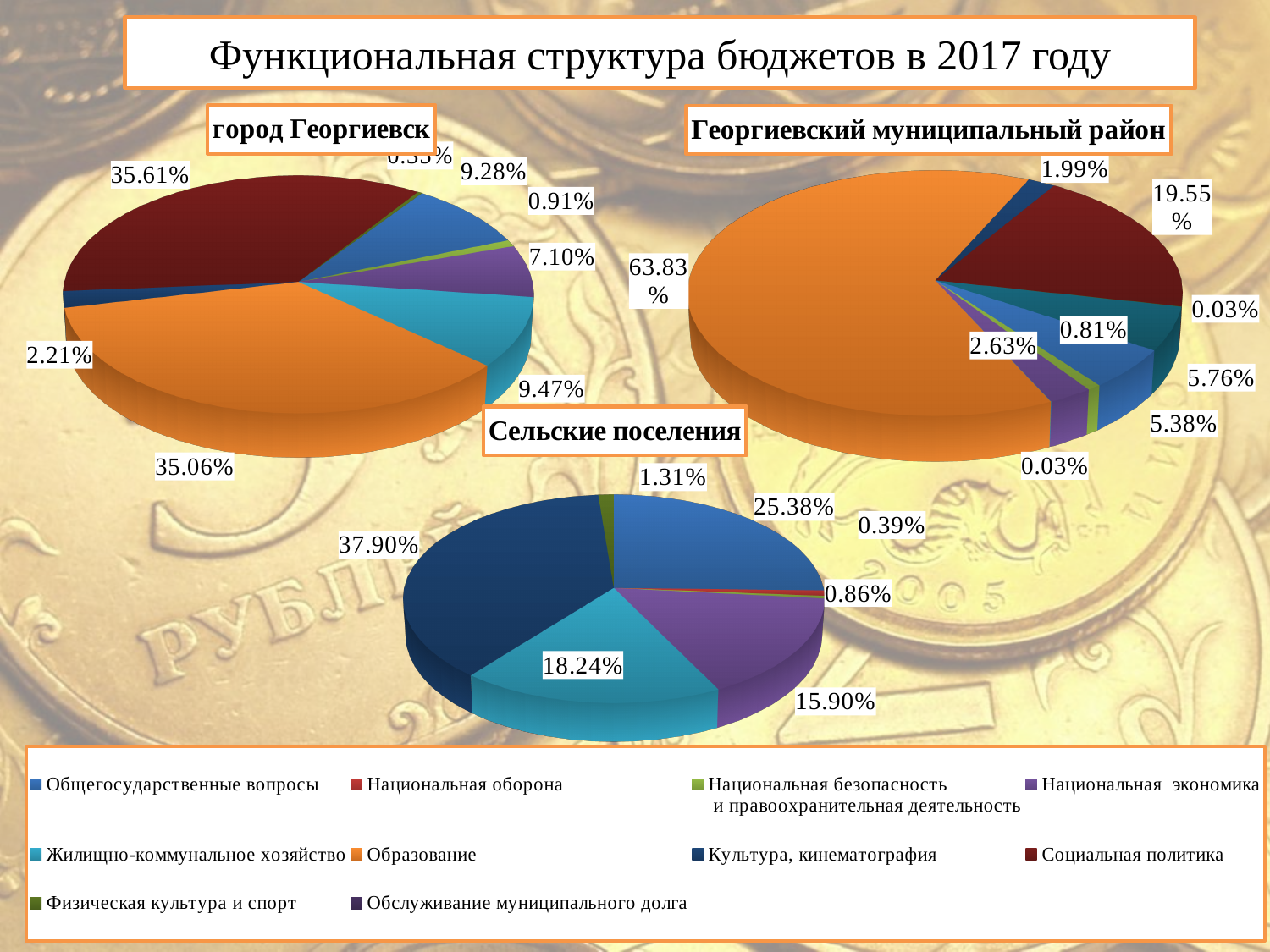
In the 'город Георгиевск' chart, what share does Социальная политика have? 35.61% In the 'город Георгиевск' chart, which is larger: Социальная политика or Образование? Социальная политика How many categories does the legend list? 10 In the 'Георгиевский муниципальный район' chart, what share does Социальная политика have? 19.55% What is the title of the slide? Функциональная структура бюджетов в 2017 году In the 'Сельские поселения' chart, what share does Жилищно-коммунальное хозяйство have? 18.24% In the 'Георгиевский муниципальный район' chart, what is the difference between the shares of Образование and Социальная политика? 44.28% How many pie charts are on the slide? 3 In the 'Георгиевский муниципальный район' chart, which category has the largest share? Образование In the 'Сельские поселения' chart, which category has the largest share? Культура, кинематография In the 'город Георгиевск' chart, what share does Образование have? 35.06% What kind of charts are shown on the slide? Pie charts